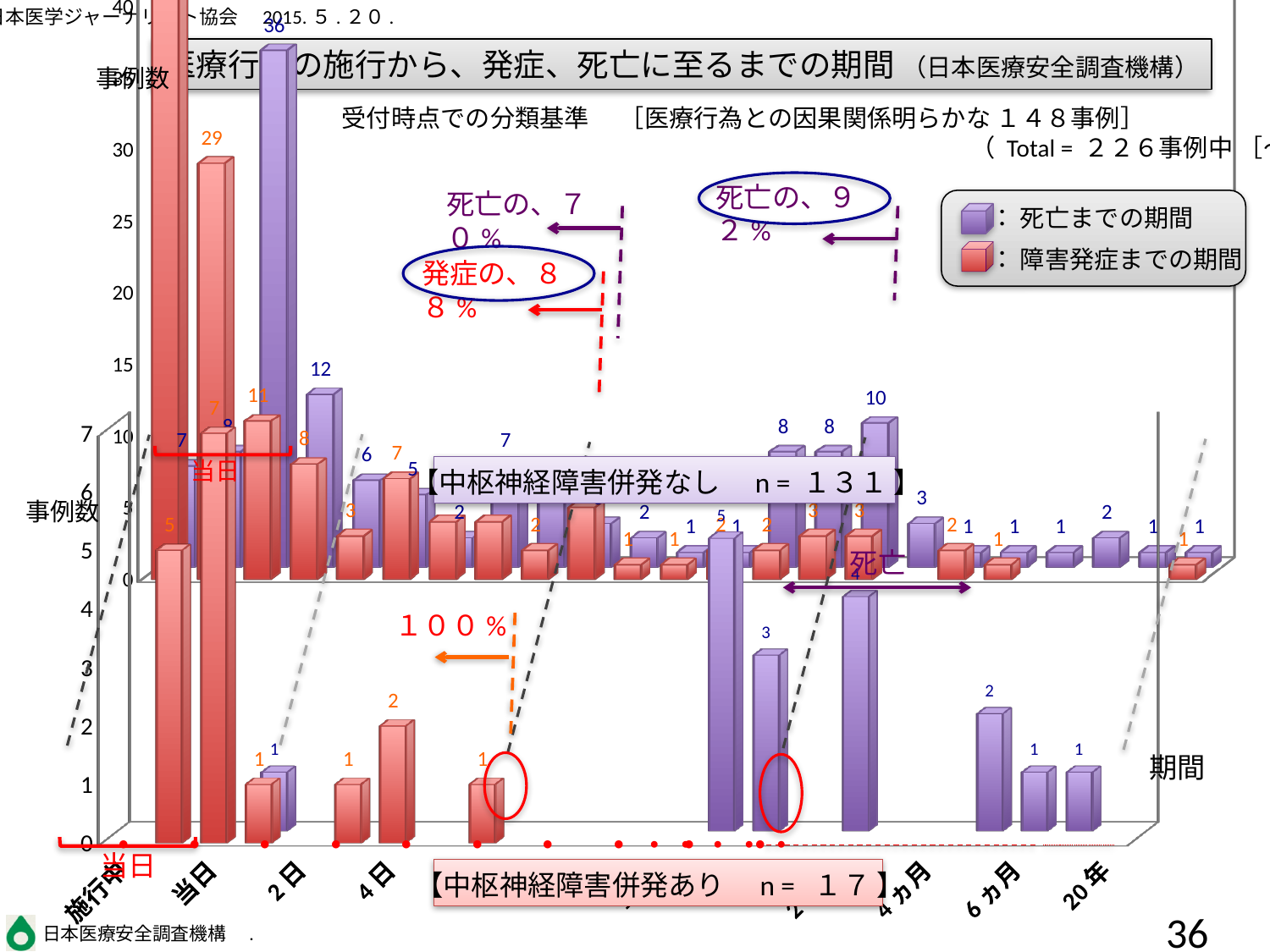
What is the n value stated for the upper chart (中枢神経障害併発なし)? 131 What kind of chart is used on this slide? bar chart Which series does the purple colour represent in the legend? 死亡までの期間 In the lower chart (中枢神経障害併発あり), what is the highest value shown for the 障害発症までの期間 (red) series? 7 In the upper chart (中枢神経障害併発なし), which series has the taller maximum bar, 死亡までの期間 or 障害発症までの期間? 障害発症までの期間 How many series does the legend list? 2 In the upper chart (中枢神経障害併発なし), what is the highest value shown for the 死亡までの期間 series? 36